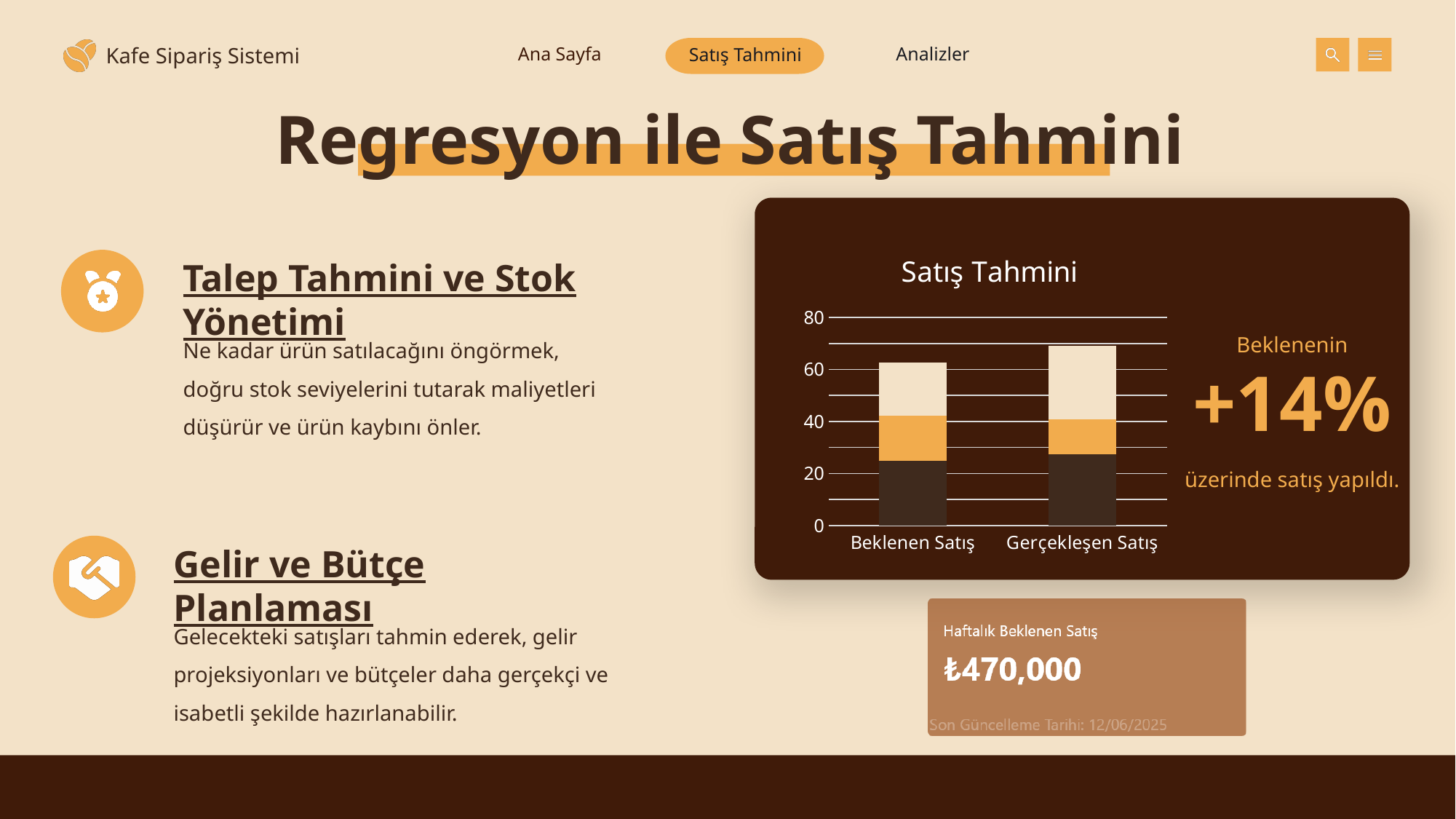
What kind of chart is shown on the slide? stacked bar chart How many categories are shown on the x axis of the chart? 2 Is the total for Beklenen Satış greater or less than 80? less What is the title of the chart? Satış Tahmini Is the total for Beklenen Satış greater or less than 40? greater Which category has the taller stacked bar, Beklenen Satış or Gerçekleşen Satış? Gerçekleşen Satış Is the total for Gerçekleşen Satış greater or less than 60? greater How many stacked segments does each bar in the chart have? 3 Which category has the highest total in the chart? Gerçekleşen Satış Which category has the lowest total in the chart? Beklenen Satış What is the highest value shown on the chart's vertical axis? 80